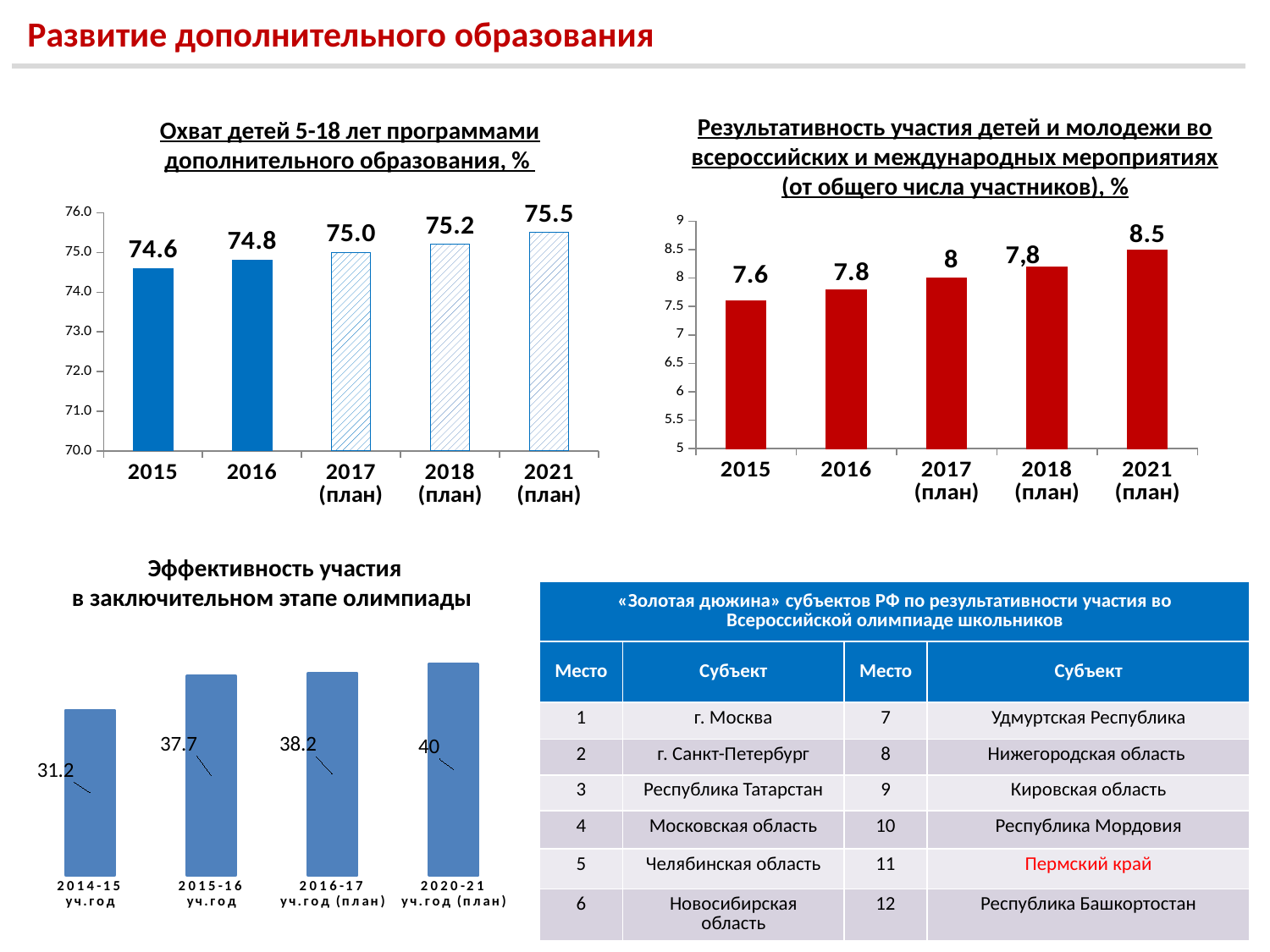
In the chart 'Результативность участия детей и молодежи во всероссийских и международных мероприятиях', which year has the highest value? 2021 (план) In the chart 'Охват детей 5-18 лет программами дополнительного образования, %', which year has the lowest value? 2015 In the chart 'Охват детей 5-18 лет программами дополнительного образования, %', do the values rise or fall from 2015 to 2021 (план)? rise In the chart 'Результативность участия детей и молодежи во всероссийских и международных мероприятиях', how many bars are plotted? 5 In the chart 'Эффективность участия в заключительном этапе олимпиады', what is the difference between the 2020-21 уч.год (план) value and the 2014-15 уч.год value? 8.8 In the chart 'Охват детей 5-18 лет программами дополнительного образования, %', what is the value for 2021 (план)? 75.5 What kind of chart is 'Эффективность участия в заключительном этапе олимпиады'? bar chart In the chart 'Результативность участия детей и молодежи во всероссийских и международных мероприятиях', what colour are the bars? red In the chart 'Охват детей 5-18 лет программами дополнительного образования, %', what is the difference between the 2021 (план) value and the 2015 value? 0.9 In the chart 'Охват детей 5-18 лет программами дополнительного образования, %', what is the value for 2015? 74.6 In the chart 'Результативность участия детей и молодежи во всероссийских и международных мероприятиях', what is the value for 2016? 7.8 In the chart 'Эффективность участия в заключительном этапе олимпиады', what is the value for 2015-16 уч.год? 37.7